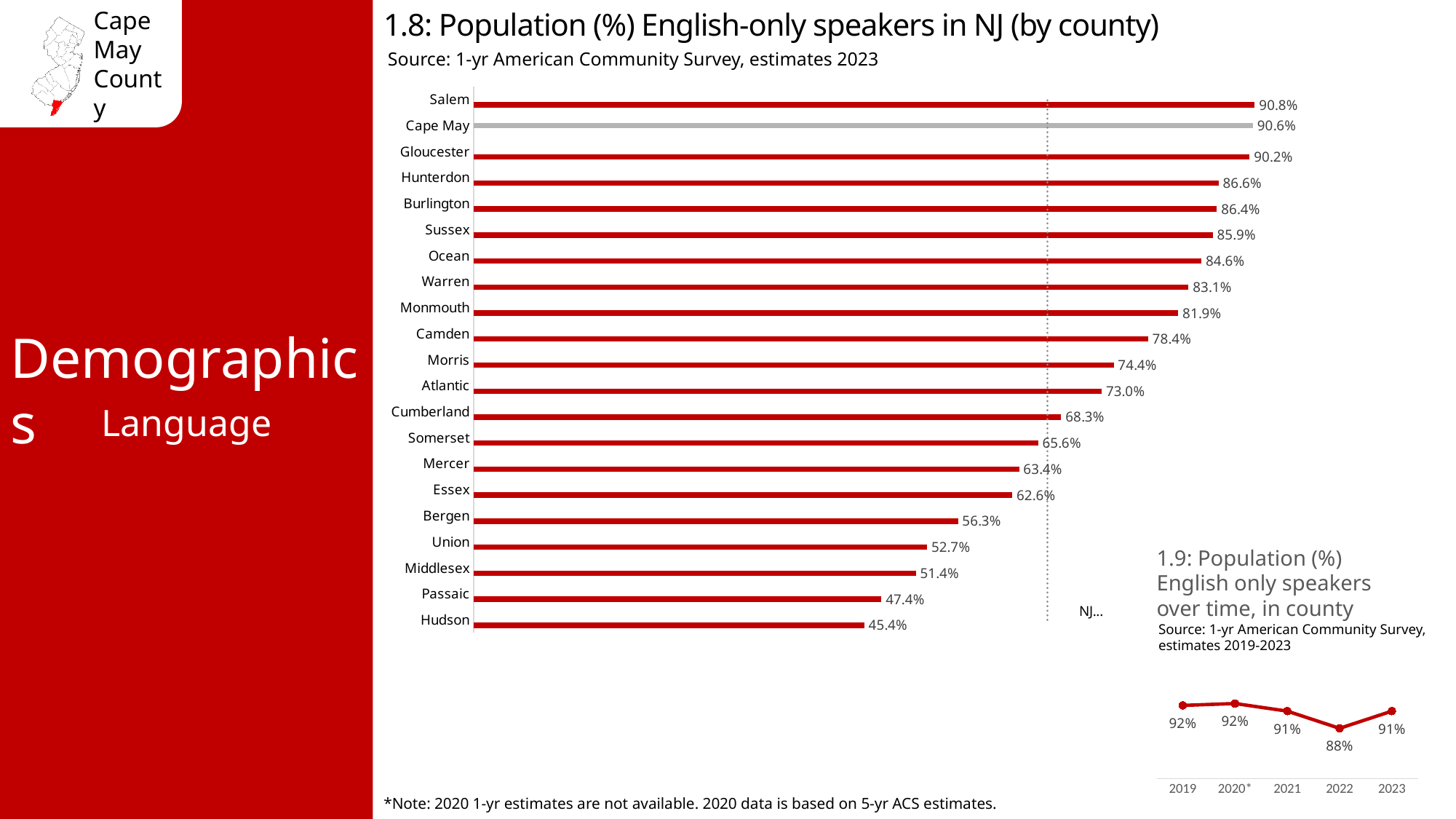
In chart 1.8, which county has the highest percentage of English-only speakers? Salem In chart 1.8, how many counties are shown? 21 In chart 1.8, which has a higher value, Bergen or Essex? Essex What type of chart is chart 1.8? Bar chart In chart 1.9, which year has the lowest value? 2022 In chart 1.8, what is the difference between Salem and Cape May? 0.2% In chart 1.8, what is the value for Hudson? 45.4% In chart 1.9, what is the value for 2022? 88% In chart 1.8, what percentage of Cape May's population are English-only speakers? 90.6% In chart 1.9, how many years are plotted? 5 In chart 1.8, which county has the lowest percentage of English-only speakers? Hudson In chart 1.8, which county's bar is coloured grey instead of red? Cape May